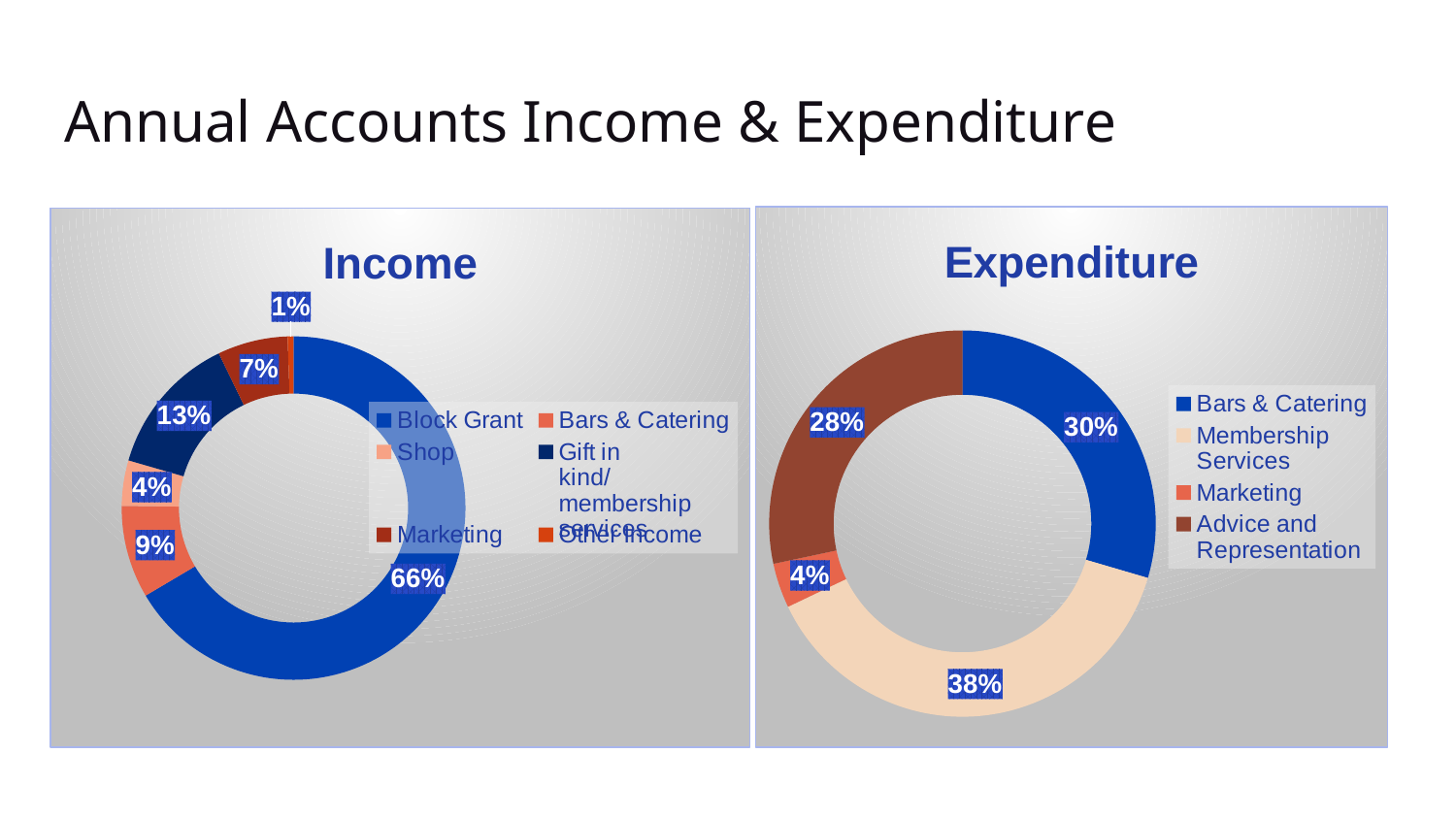
In the Expenditure chart, what percentage is shown for Membership Services? 38% What type of chart is the Expenditure chart? Doughnut chart In the Expenditure chart, what percentage is shown for Advice and Representation? 28% In the Income chart, which category has the smallest share? Other income In the Income chart, what percentage is shown for Gift in kind/membership services? 13% In the Expenditure chart, which is larger: Bars & Catering or Advice and Representation? Bars & Catering In the Income chart, what is the difference between the Block Grant share and the Gift in kind/membership services share? 53% In the Income chart, what percentage is shown for Bars & Catering? 9% In the Expenditure chart, what is the difference between Membership Services and Marketing? 34% In the Income chart, how many categories does the legend list? 6 In the Income chart, what share of income comes from the Block Grant? 66% In the Expenditure chart, which category has the largest share? Membership Services